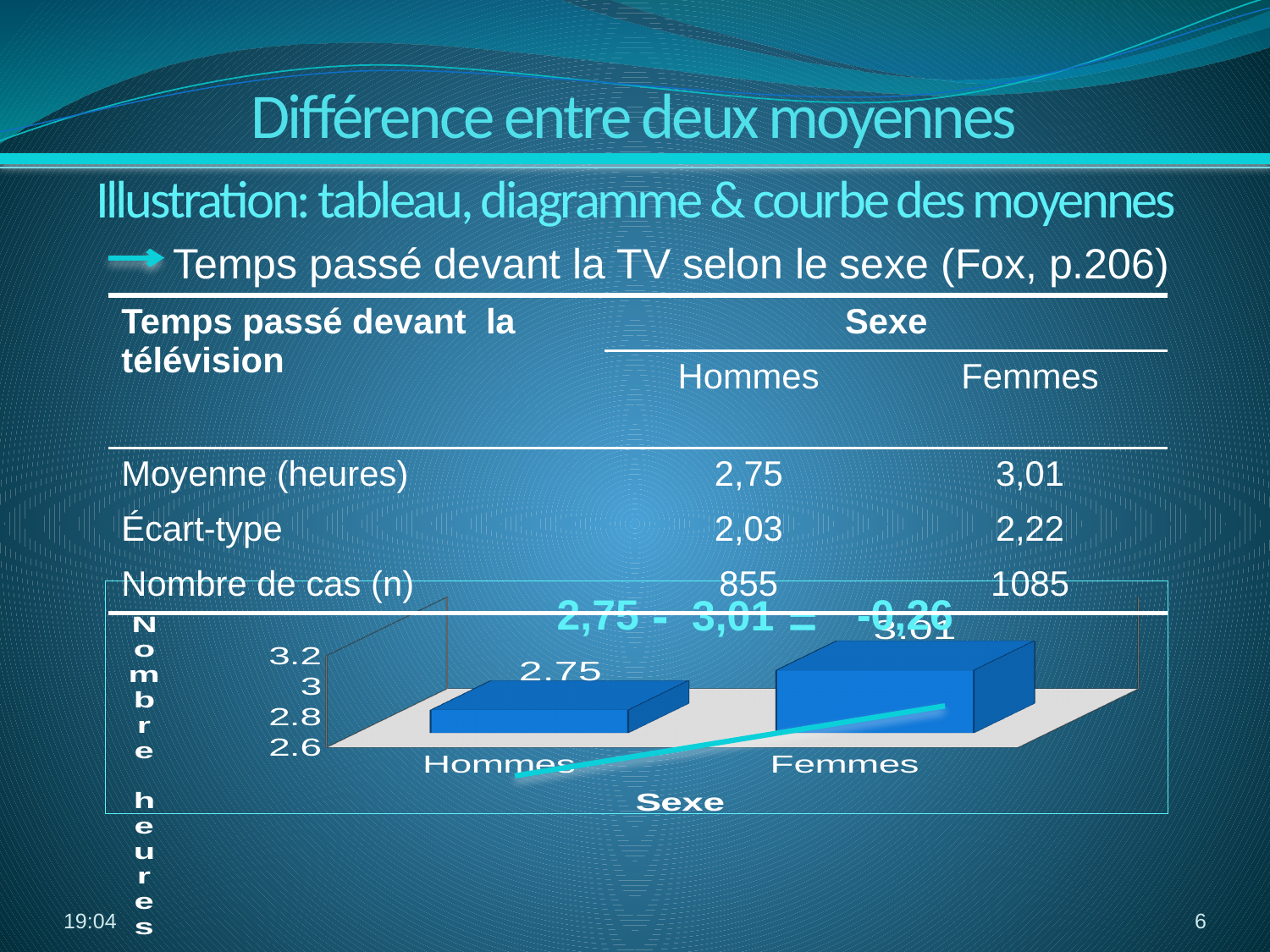
Which category has the lower bar in the chart? Hommes Do the bar values rise or fall from Hommes to Femmes? rise Which category has the higher bar in the chart? Femmes Is the value for Femmes greater or less than 3? greater Is the value for Hommes greater or less than the value for Femmes? less How many categories are plotted in the bar chart? 2 What is the title of the horizontal axis of the chart? Sexe What is the value shown for Hommes in the bar chart? 2.75 What type of chart is shown on the slide? bar chart Is the value for Hommes greater or less than 3? less What is the value shown for Femmes in the bar chart? 3.01 What is the difference between the values for Femmes and Hommes in the chart? 0.26